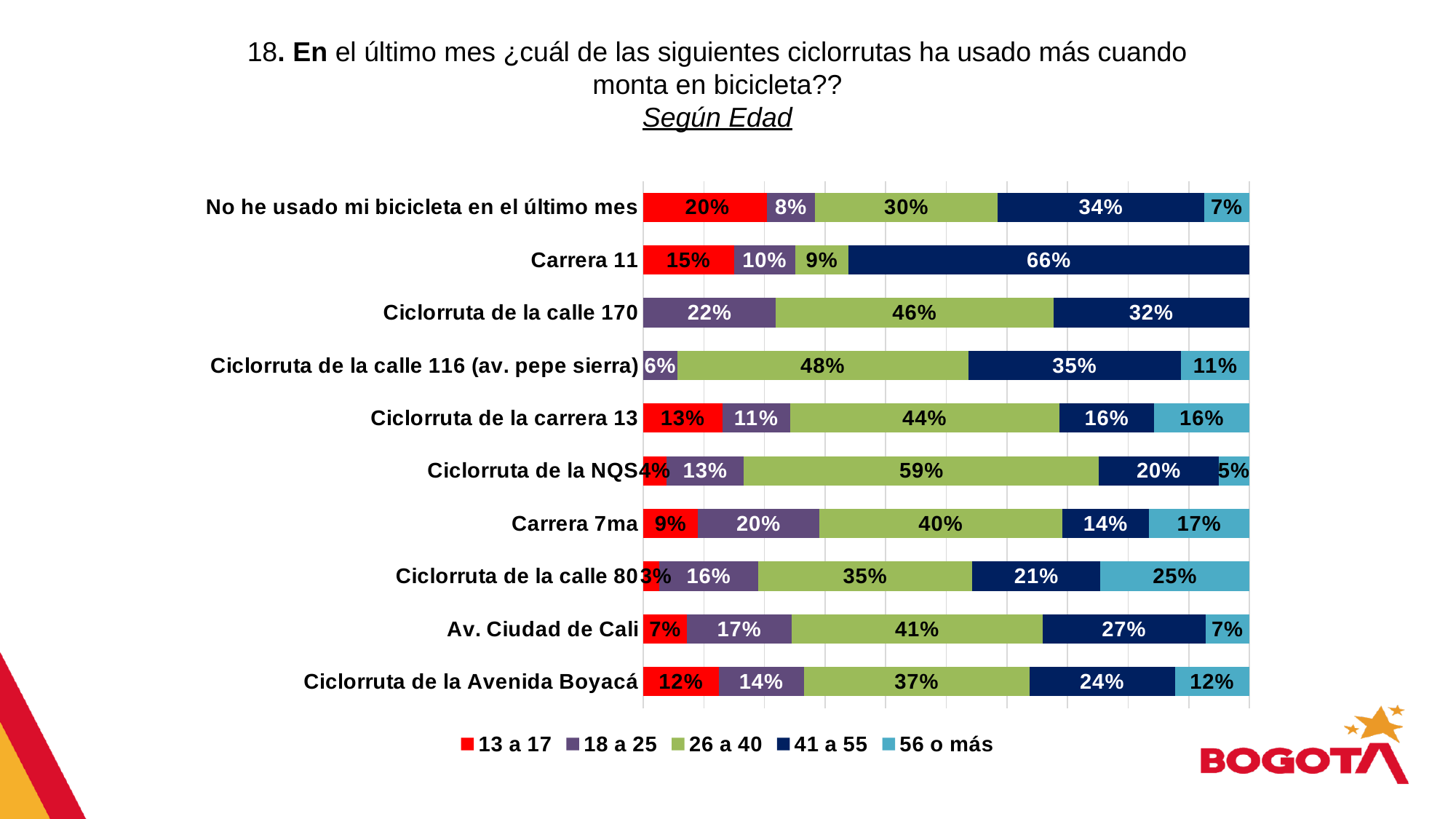
What is the difference between the 26 a 40 value and the 41 a 55 value for Ciclorruta de la calle 170? 14% Which category has the highest value for the 26 a 40 age group? Ciclorruta de la NQS What is the value for the 13 a 17 age group for Ciclorruta de la Avenida Boyacá? 12% What kind of chart is shown on the slide? Stacked bar chart What is the value for the 56 o más age group for Ciclorruta de la calle 80? 25% What is the value for the 41 a 55 age group for Carrera 11? 66% Which category has the highest value for the 41 a 55 age group? Carrera 11 Which is larger for Carrera 7ma: the 18 a 25 value or the 56 o más value? 18 a 25 What percentage of the 26 a 40 age group is shown for Ciclorruta de la NQS? 59% How many age groups does the legend list? 5 How many categories (ciclorrutas/options) are shown on the chart? 10 Which category has the lowest value for the 26 a 40 age group? Carrera 11